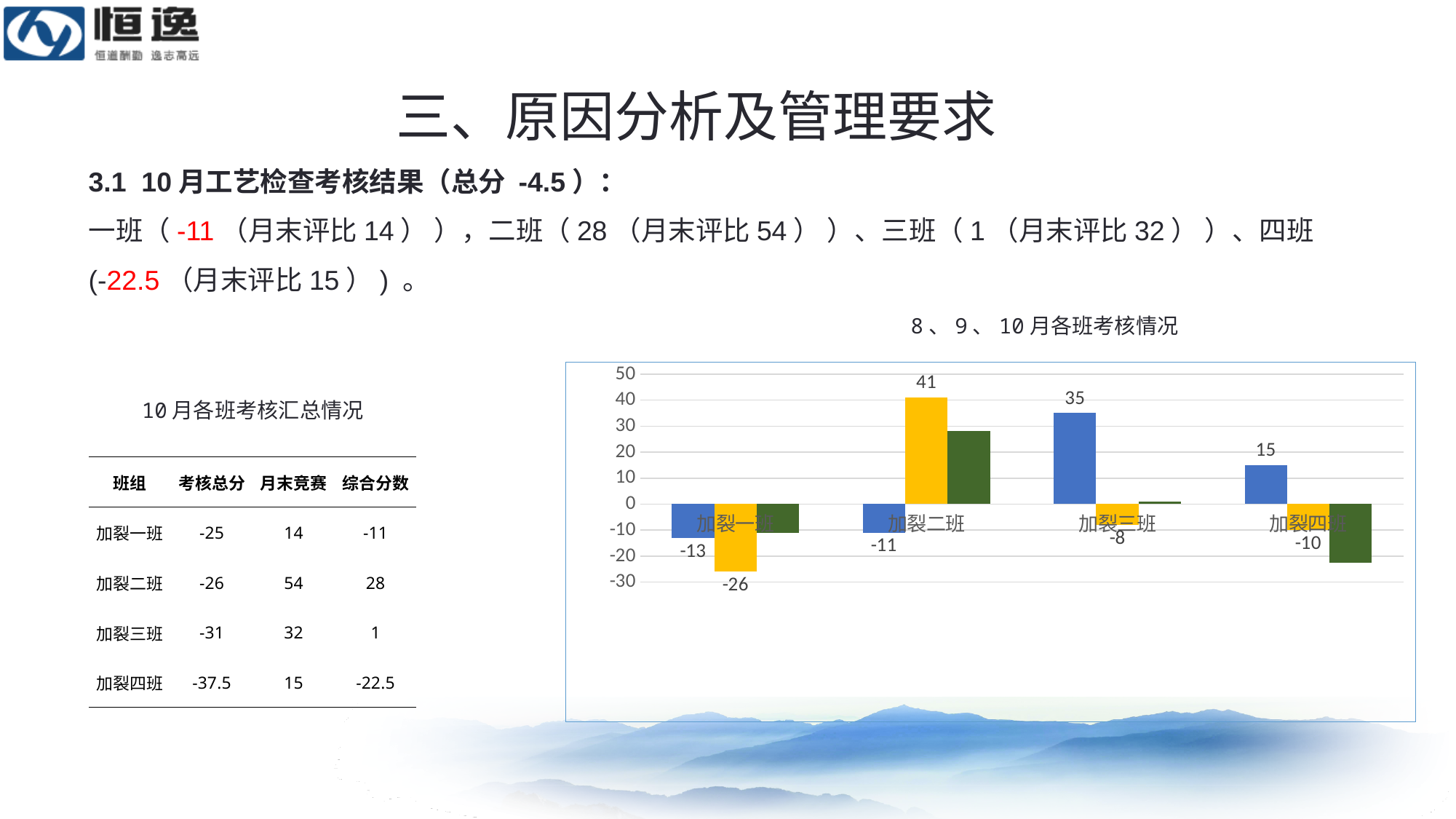
Which is larger: the yellow bar for 加裂二班 or the blue bar for 加裂三班? the yellow bar for 加裂二班 Which category has the lowest yellow bar? 加裂一班 How many categories (班组) are shown on the x axis of the chart? 4 How many bars are plotted for each category in the chart? 3 What is the difference between the blue bar for 加裂三班 and the blue bar for 加裂四班? 20 What is the value of the blue bar for 加裂一班? -13 Which category has the highest blue bar? 加裂三班 What is the value of the yellow bar for 加裂四班? -10 What is the value of the blue bar for 加裂三班? 35 What is the value of the yellow bar for 加裂二班? 41 What kind of chart is shown on the slide? bar chart Is the value of the green bar for 加裂二班 greater or less than 20? greater